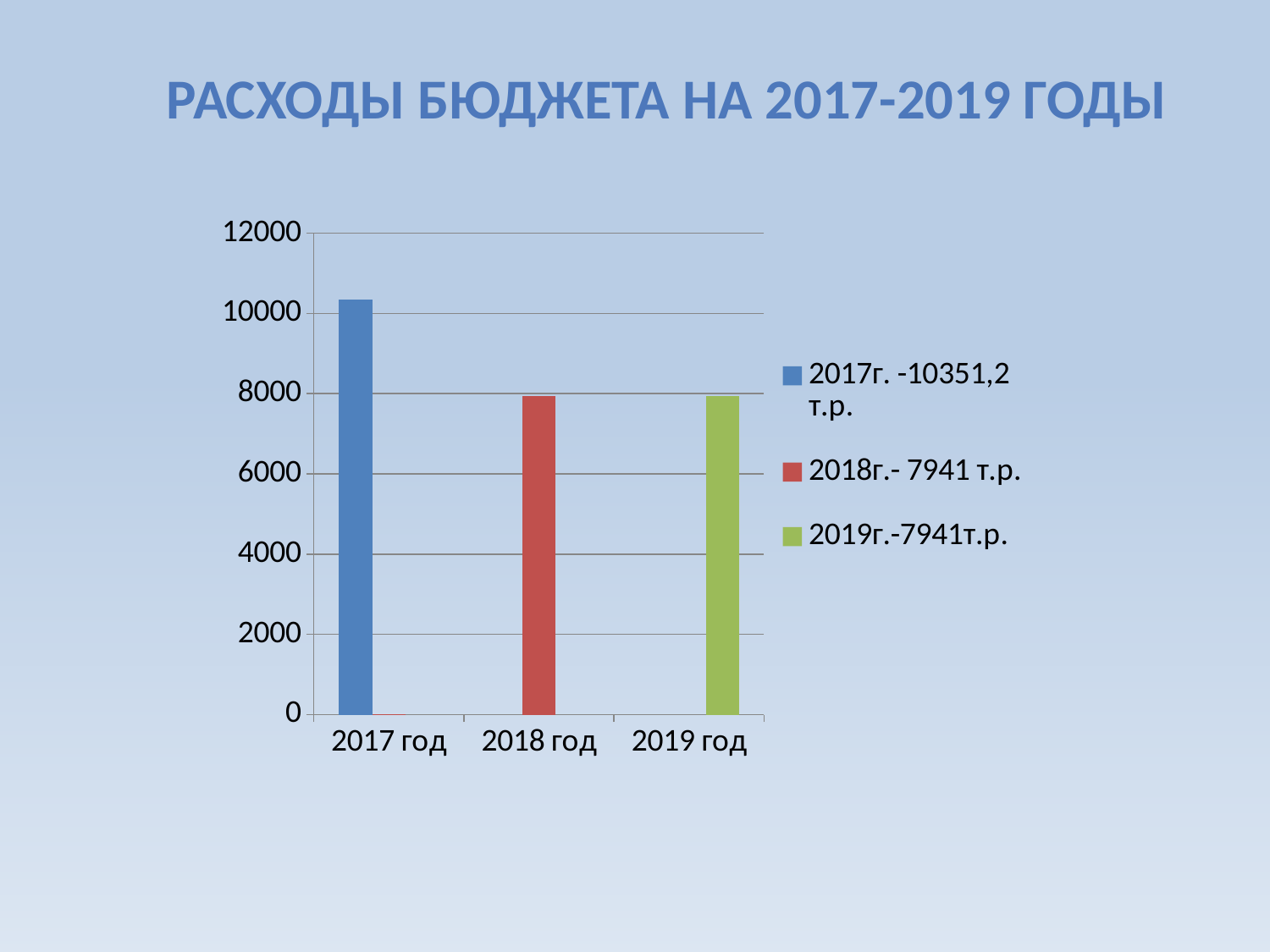
Is the value for 2017 год greater or less than 10000? greater Is the value for 2019 год greater or less than 8000? less What is the title of the slide? РАСХОДЫ БЮДЖЕТА НА 2017-2019 ГОДЫ What kind of chart is shown on the slide? bar chart What is the value for 2018 год according to the legend? 7941 т.р. Which year has the highest bar? 2017 год What is the difference between the values for 2017 год and 2018 год? 2410,2 т.р. Do the values rise or fall from 2017 год to 2018 год? fall Which is larger, the value for 2017 год or for 2018 год? 2017 год How many categories (years) are plotted on the x axis? 3 What is the value for 2017 год according to the legend? 10351,2 т.р. How many entries does the legend list? 3